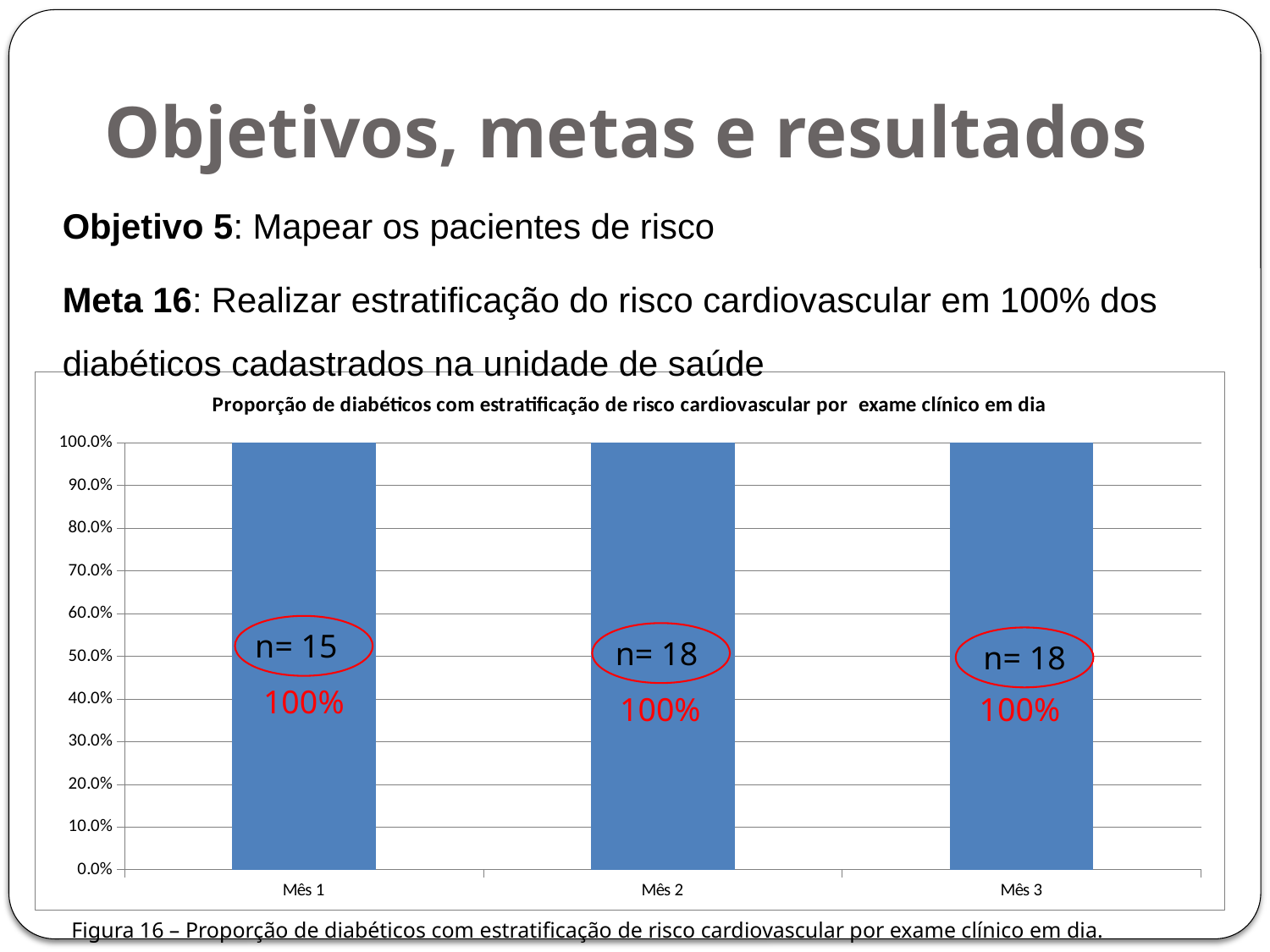
What is the n value annotated on the bar for Mês 1? n= 15 Do the values rise, fall or stay the same from Mês 1 to Mês 3? Stay the same What is the title of the chart? Proporção de diabéticos com estratificação de risco cardiovascular por exame clínico em dia Is the value for Mês 2 greater or less than 50.0%? greater How many categories are shown on the x axis? 3 What is the value for Mês 1? 100% What kind of chart is shown on the slide? Bar chart What is the n value annotated on the bar for Mês 3? n= 18 What is the value for Mês 3? 100% What is the n value annotated on the bar for Mês 2? n= 18 What is the value for Mês 2? 100% What is the difference between the values for Mês 1 and Mês 3? 0%